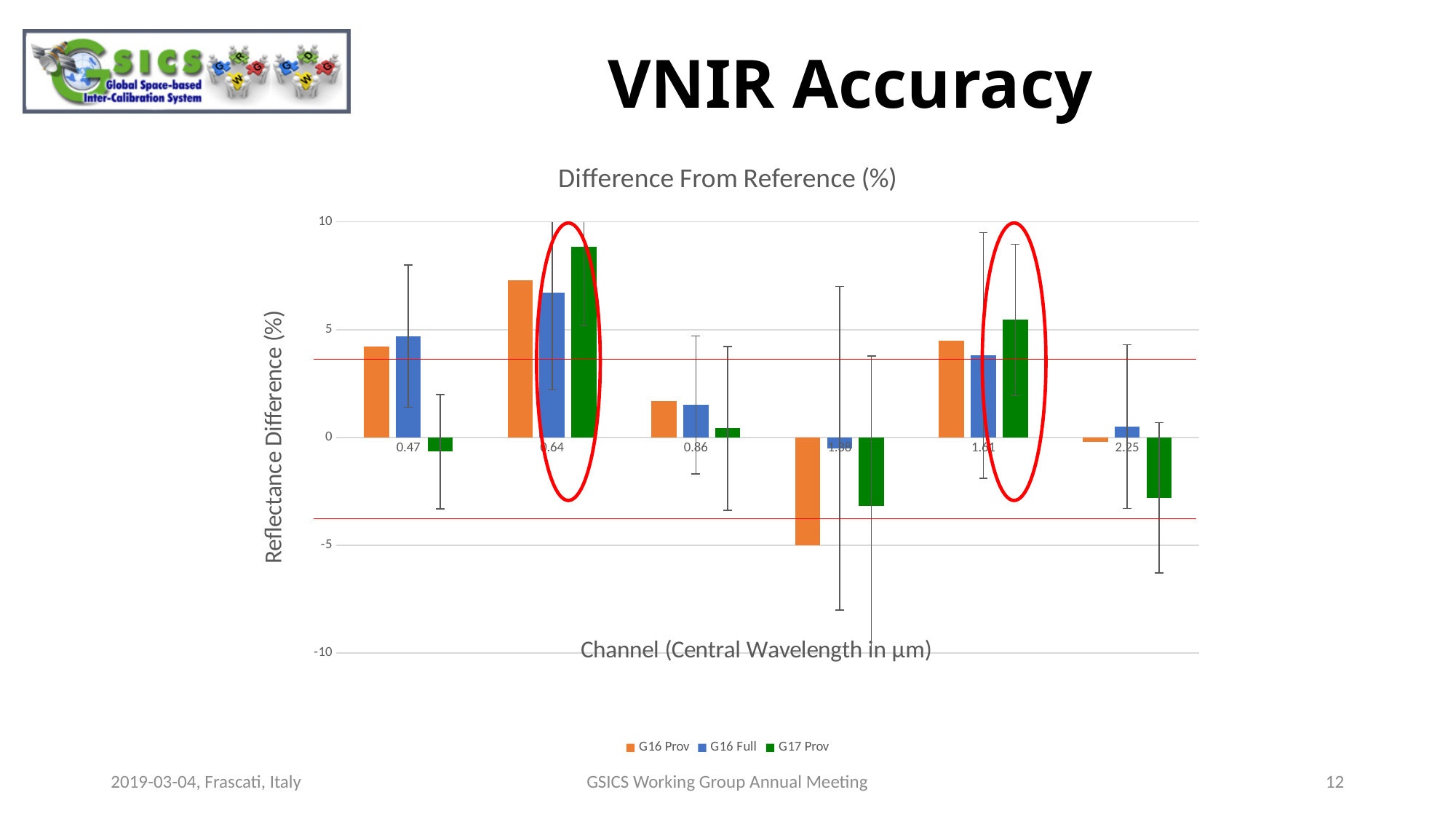
What is the title of the chart? Difference From Reference (%) What kind of chart is shown on the slide? bar chart Is the value for G17 Prov at 2.25 greater or less than 0? less Which series and channel has the highest bar in the chart? G17 Prov at 0.64 Which series is drawn in green? G17 Prov Is the value for G17 Prov at 0.64 greater or less than 5? greater Which series and channel has the lowest bar in the chart? G16 Prov at 1.38 Is the value for G16 Prov at 0.47 greater or less than 5? less How many series does the legend list? 3 At channel 0.86, which is larger: G16 Prov or G17 Prov? G16 Prov At channel 1.61, which is larger: G16 Full or G17 Prov? G17 Prov How many channel categories are plotted along the x axis? 6